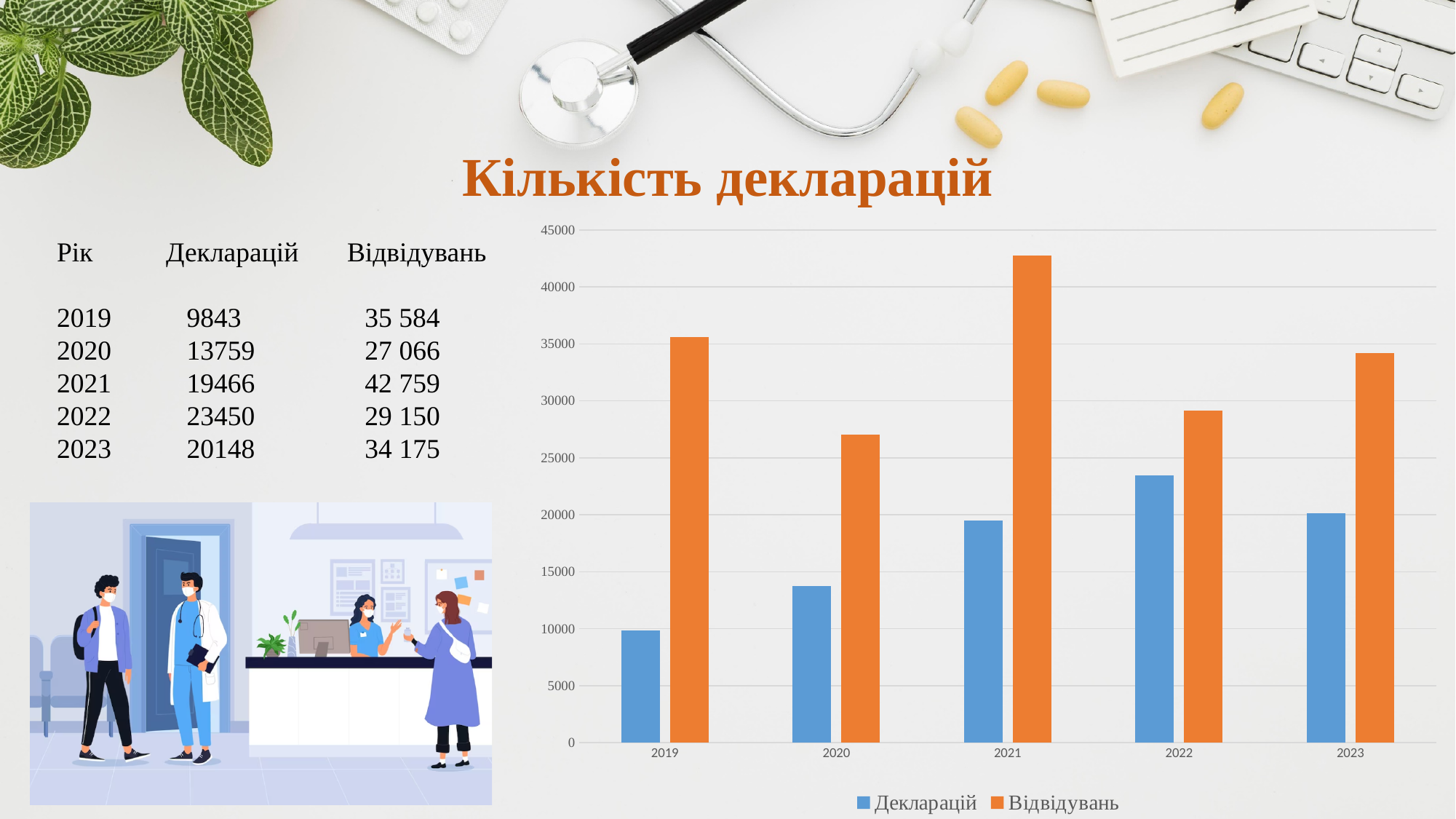
What kind of chart is shown on the slide? bar chart What is the value of Декларацій for 2021? 19466 Which year has the lowest value of Декларацій? 2019 What colour are the Відвідувань bars in the chart? orange Do the Декларацій values rise or fall from 2019 to 2022? rise Is the value of Відвідувань for 2022 greater or less than 30000? less How many years are shown on the x axis of the chart? 5 What is the difference between Декларацій in 2022 and in 2019? 13607 How many series does the chart legend list? 2 Which year has the highest value of Відвідувань? 2021 What is the value of Відвідувань for 2020? 27 066 Which is larger: Відвідувань in 2019 or Відвідувань in 2023? Відвідувань in 2019